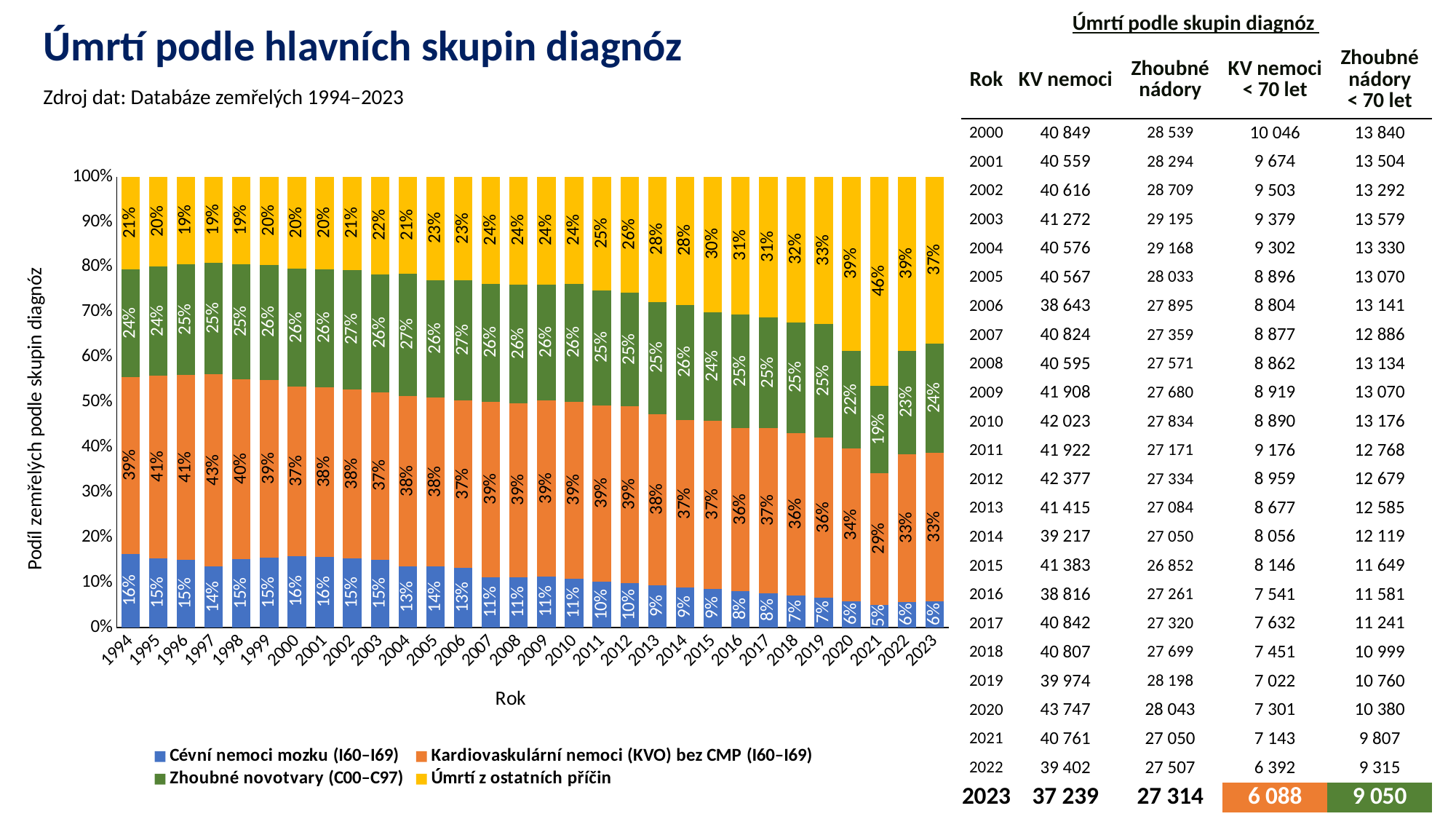
In which year is the share of 'Kardiovaskulární nemoci (KVO) bez CMP (I60–I69)' the highest? 1997 How many series does the chart legend list? 4 What is the share of 'Cévní nemoci mozku (I60–I69)' in 1994? 16% How many years are plotted along the x axis of the chart? 30 In which year is the share of 'Úmrtí z ostatních příčin' the highest? 2021 By how many percentage points did the share of 'Cévní nemoci mozku (I60–I69)' fall from 1994 to 2023? 10 percentage points What kind of chart is shown on the slide? Stacked bar chart What is the share of 'Zhoubné novotvary (C00–C97)' in 2023? 24% What is the share of 'Úmrtí z ostatních příčin' in 2021? 46% Does the share of 'Úmrtí z ostatních příčin' generally rise or fall from 1994 to 2023? Rise Which year has the larger share of 'Kardiovaskulární nemoci (KVO) bez CMP (I60–I69)', 1997 or 2021? 1997 In which year is the share of 'Cévní nemoci mozku (I60–I69)' the lowest? 2021